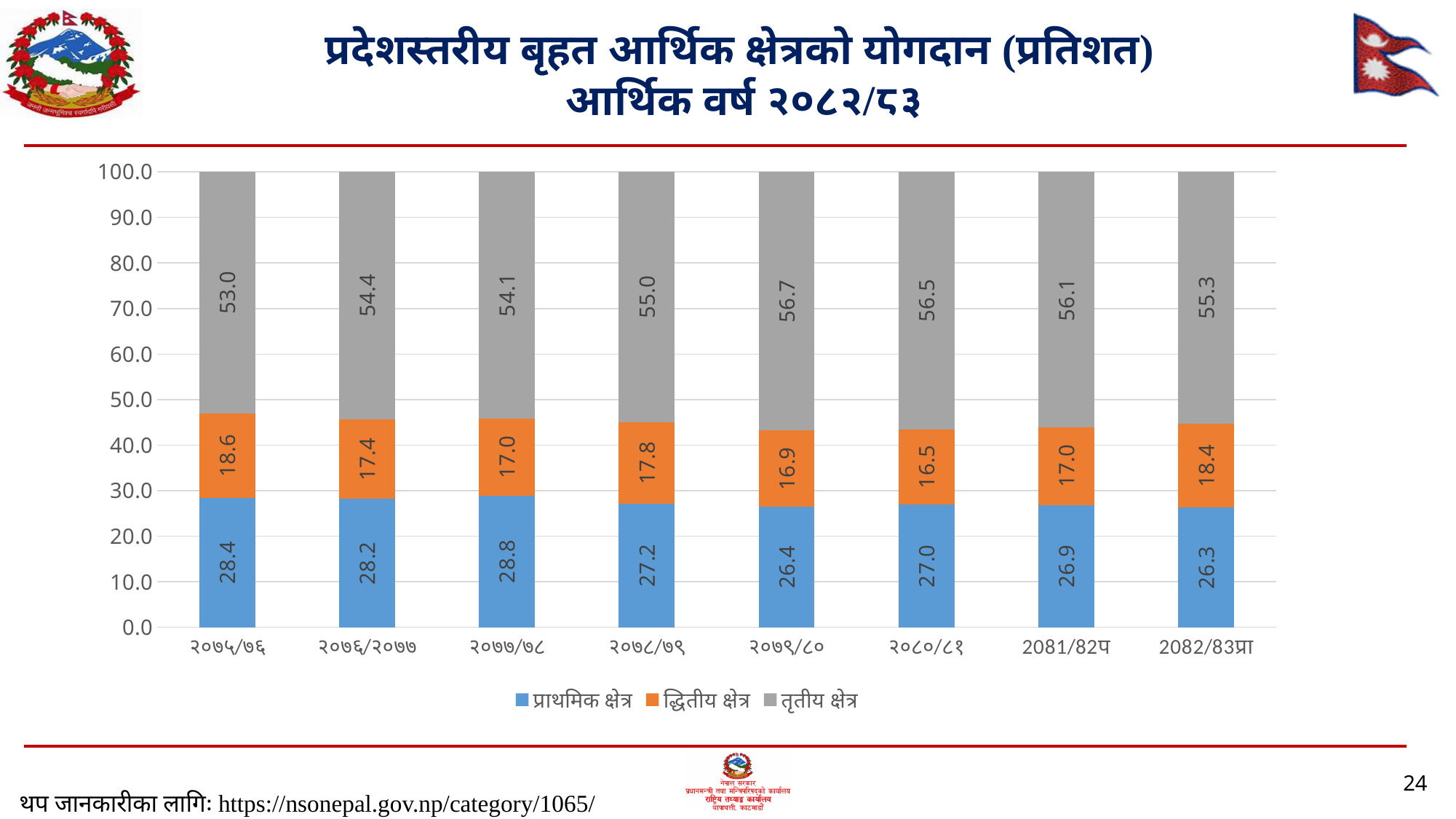
How many series does the legend list? 3 What is the value of द्वितीय क्षेत्र for २०८०/८१? 16.5 In which fiscal year is the तृतीय क्षेत्र value highest? २०७९/८० What type of chart is shown on the slide? Stacked bar chart How many fiscal years (categories) are shown on the x axis? 8 What is the difference between the तृतीय क्षेत्र values for २०७९/८० and २०७५/७६? 3.7 What is the value of तृतीय क्षेत्र for 2082/83प्रा? 55.3 Which is larger: the द्वितीय क्षेत्र value for २०७५/७६ or for २०७९/८०? २०७५/७६ In which fiscal year is the प्राथमिक क्षेत्र value lowest? 2082/83प्रा What is the value of प्राथमिक क्षेत्र for २०७५/७६? 28.4 What is the total of the stacked bar for २०७७/७८? 99.9 Which colour represents तृतीय क्षेत्र in the chart? Grey